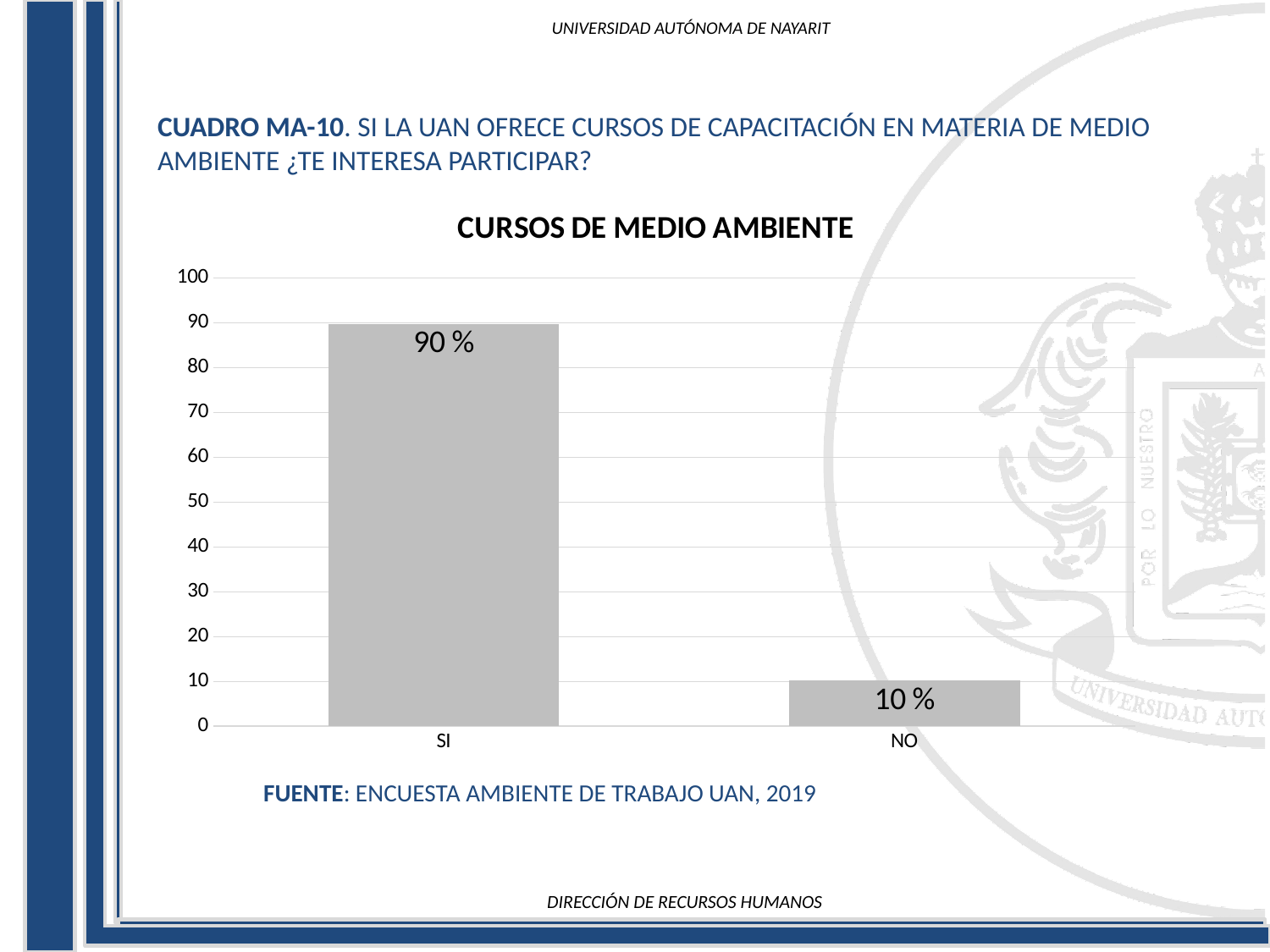
Is the value for SI greater or less than 50? greater What is the value for NO? 10 % What is the maximum value shown on the vertical axis? 100 Is the value for NO greater or less than 20? less What is the title of the chart? CURSOS DE MEDIO AMBIENTE What kind of chart is shown? bar chart Which category has the highest value? SI Which category has the lowest value? NO What is the value for SI? 90 % What is the difference between the values for SI and NO? 80 % How many categories are shown on the x axis? 2 Which is larger, the value for SI or the value for NO? SI